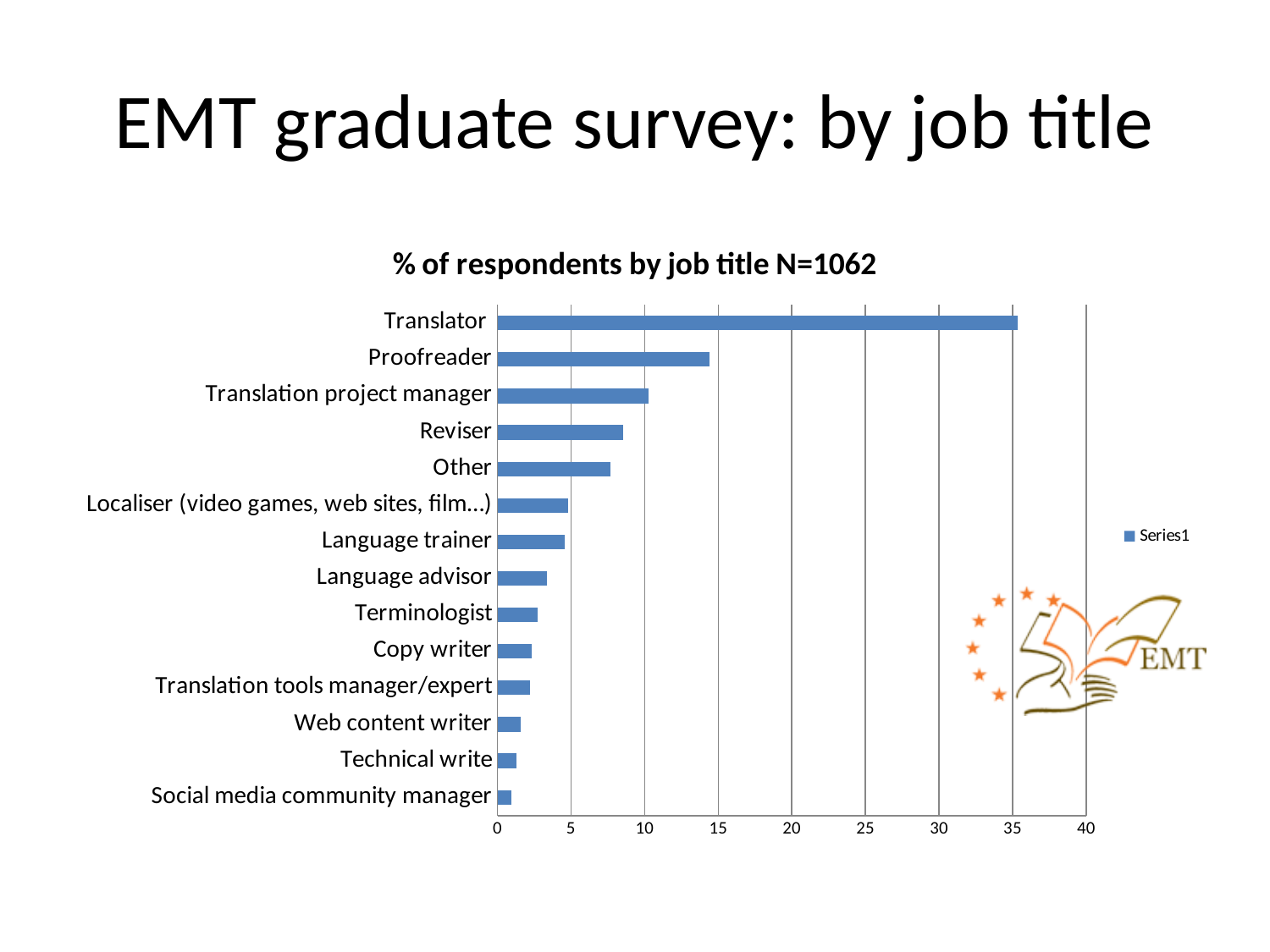
What kind of chart is shown on the slide? Bar chart Which has a larger value, Translator or Proofreader? Translator Is the value for Reviser greater or less than 10? less Which job title has the lowest percentage of respondents? Social media community manager How many job title categories are plotted in the chart? 14 Is the value for Proofreader greater or less than 15? less How many series does the legend list? 1 Is the value for Translator greater or less than 30? greater What is the title of the chart? % of respondents by job title N=1062 Which job title has the highest percentage of respondents? Translator Which has a larger value, Reviser or Other? Reviser